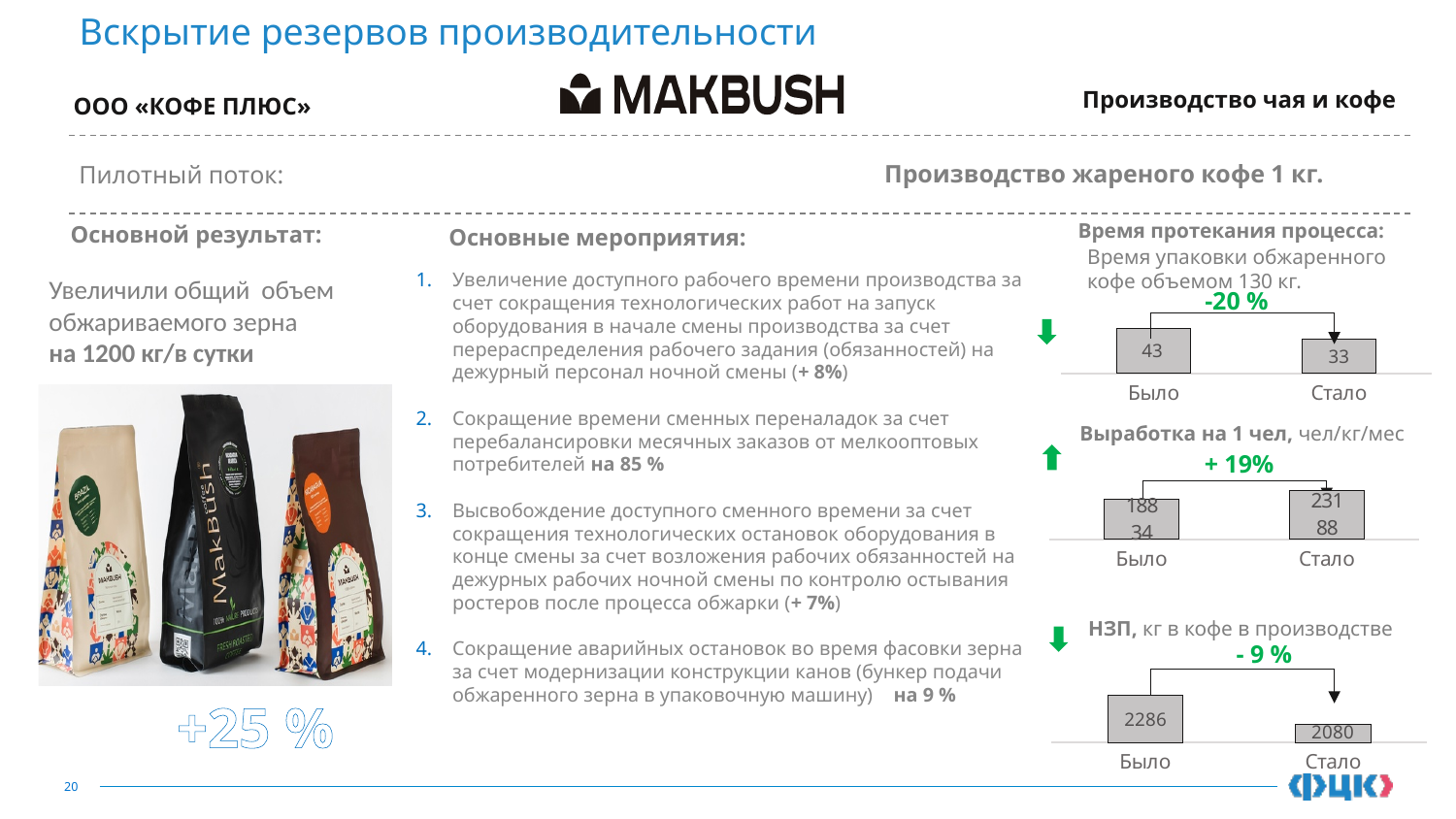
In the chart 'НЗП, кг в кофе в производстве', which category has the higher value, 'Было' or 'Стало'? Было In the chart 'НЗП, кг в кофе в производстве', what percentage change is shown? - 9 % In the chart 'НЗП, кг в кофе в производстве', what is the value for 'Было'? 2286 In the chart 'Время протекания процесса', what is the difference between 'Было' and 'Стало'? 10 What type of chart is 'НЗП, кг в кофе в производстве'? bar chart In the chart 'Время протекания процесса', what percentage change is shown between 'Было' and 'Стало'? -20 % In the chart 'Время протекания процесса', what is the value for 'Было'? 43 In the chart 'Время протекания процесса', what is the value for 'Стало'? 33 In the chart 'Выработка на 1 чел', what percentage change is shown between 'Было' and 'Стало'? + 19% In the chart 'НЗП, кг в кофе в производстве', what is the value for 'Стало'? 2080 In the chart 'НЗП, кг в кофе в производстве', what is the difference between 'Было' and 'Стало'? 206 How many categories does the chart 'Время протекания процесса' have? 2